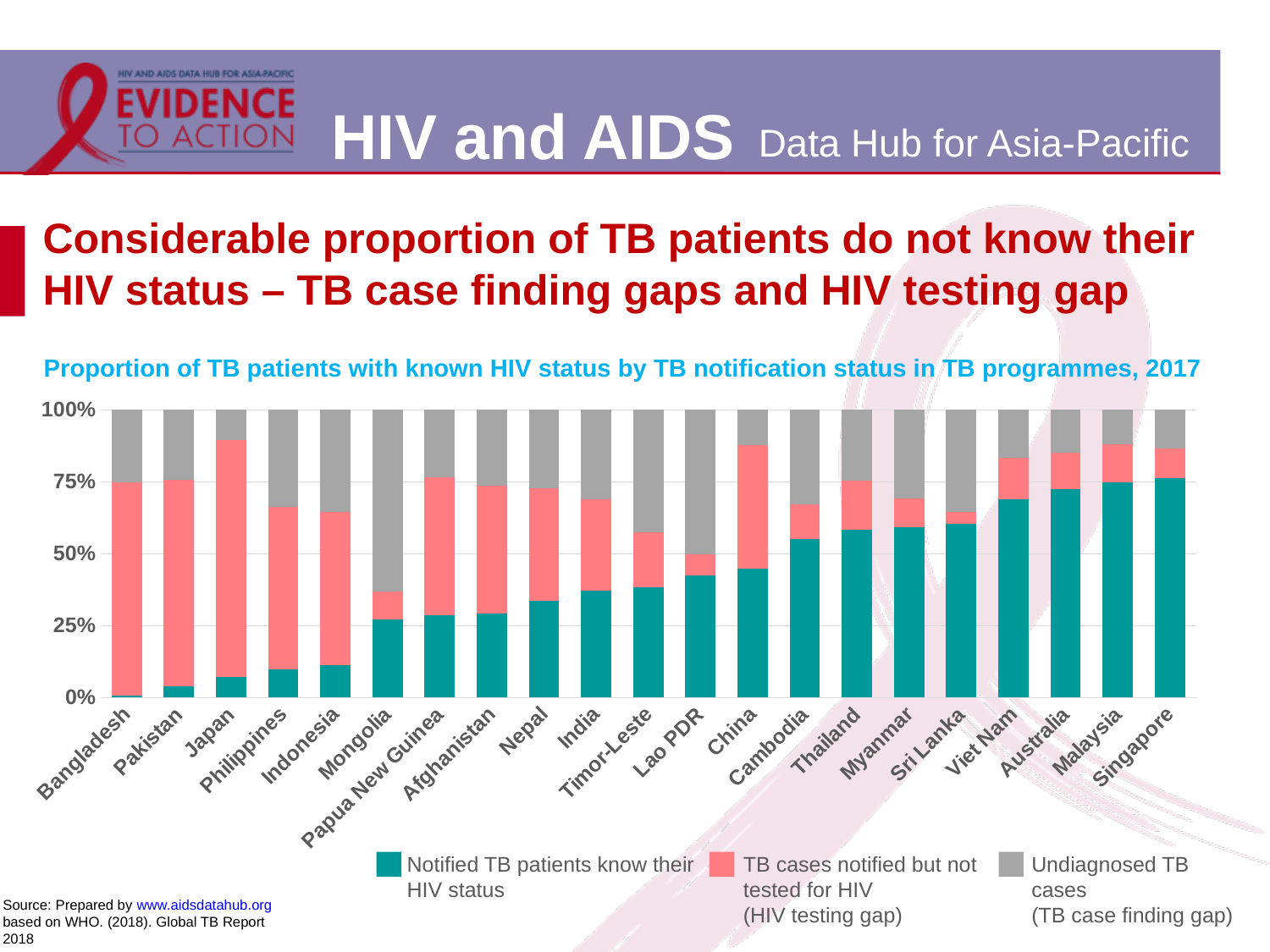
Which country has the smallest share of notified TB patients who know their HIV status (teal segment)? Bangladesh How many countries are shown on the x axis of the chart? 21 Is the share of notified TB patients who know their HIV status in Viet Nam greater or less than 75%? less Is the share of notified TB patients who know their HIV status in Japan greater or less than 25%? less What kind of chart is shown on the slide? Stacked bar chart Which colour represents undiagnosed TB cases (TB case finding gap) in the chart? Grey Which has a larger share of notified TB patients who know their HIV status, Mongolia or Indonesia? Mongolia Which country has the largest share of undiagnosed TB cases (grey segment)? Mongolia Does the share of notified TB patients who know their HIV status generally rise or fall from left to right across the countries? Rise How many series does the chart's legend list? 3 Is the share of notified TB patients who know their HIV status in Cambodia greater or less than 50%? greater Which country has the largest share of notified TB patients who know their HIV status (teal segment)? Singapore